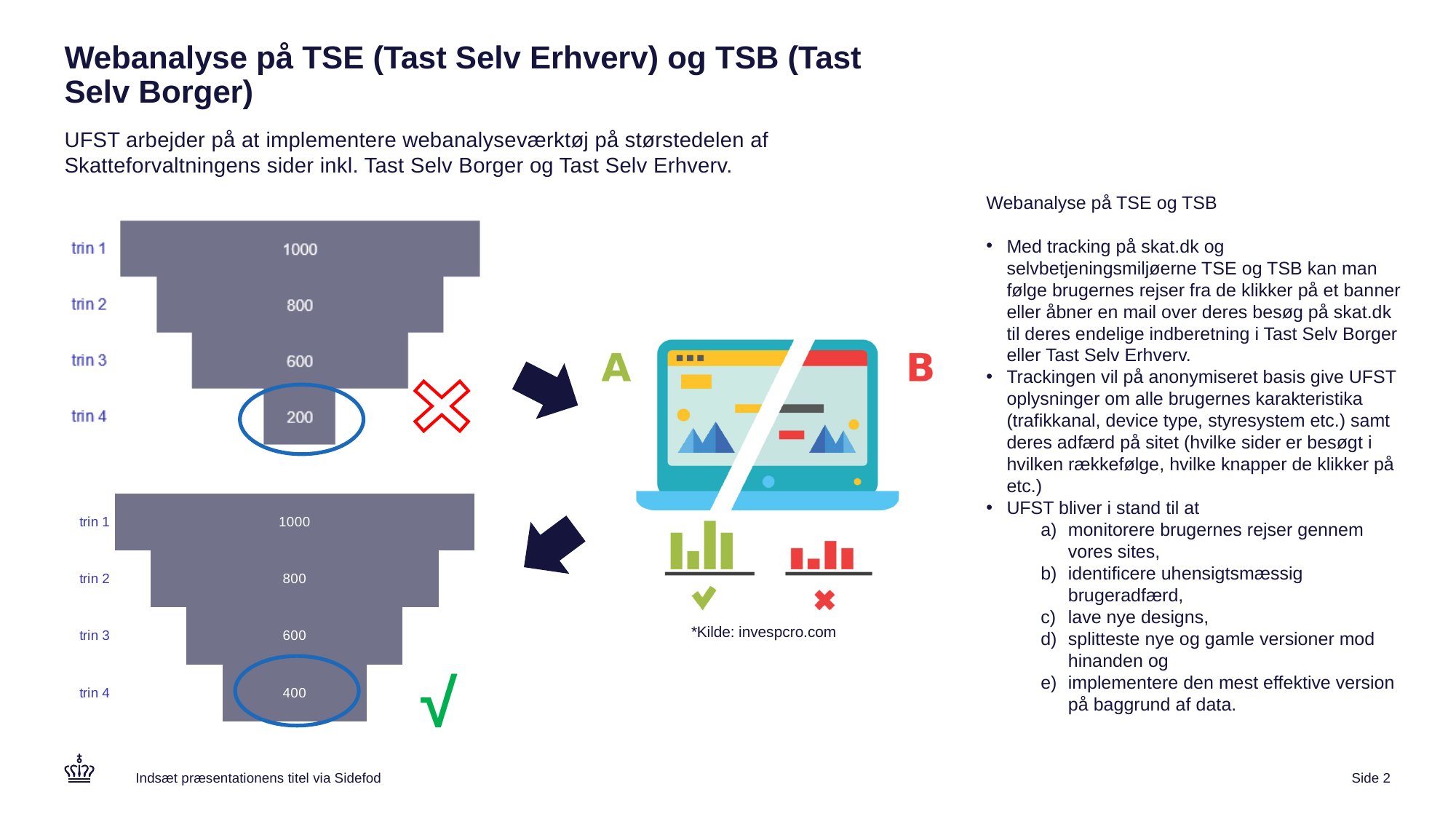
In the bottom funnel chart, what is the value for trin 2? 800 In the bottom funnel chart, what is the value for trin 4? 400 In the bottom funnel chart, which step (trin) has the highest value? trin 1 How many steps (trin) does the top funnel chart show? 4 Which is larger: the trin 4 value in the top funnel chart or the trin 4 value in the bottom funnel chart? the bottom funnel chart In the top funnel chart, what is the value for trin 1? 1000 In the top funnel chart, what is the difference between the values for trin 3 and trin 4? 400 In the top funnel chart, which step (trin) has the lowest value? trin 4 In the bottom funnel chart, do the values rise or fall from trin 1 to trin 4? fall What kind of chart is used to show the trin 1 to trin 4 values on the left of the slide? funnel chart In the bottom funnel chart, what is the difference between the values for trin 1 and trin 4? 600 In the top funnel chart, what is the value for trin 4? 200